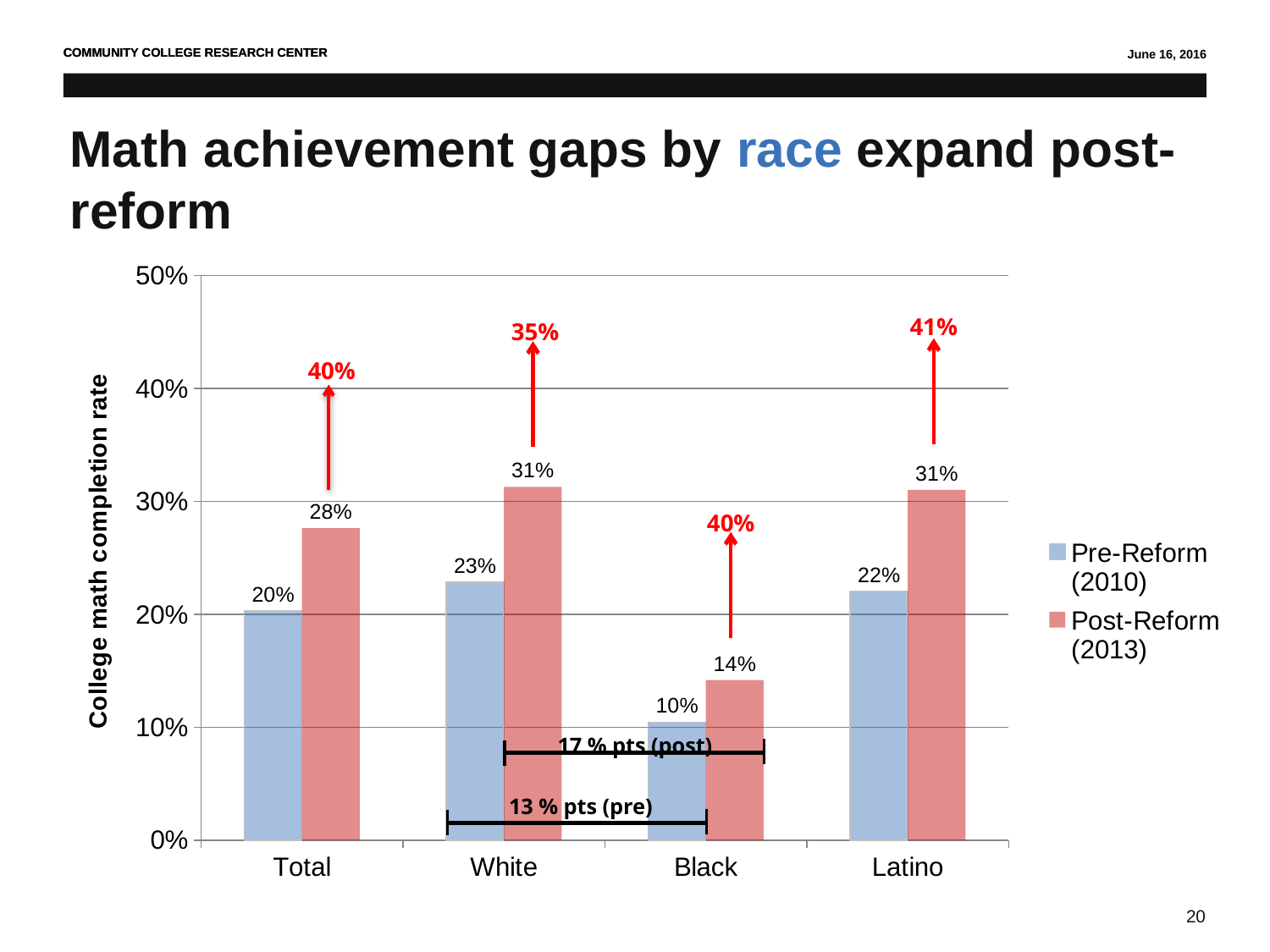
What is the Post-Reform (2013) value for the Total category? 28% What kind of chart is shown on the slide? bar chart How many categories are shown on the x axis? 4 How many series does the legend list? 2 Which category has the lowest Post-Reform (2013) completion rate? Black What is the Pre-Reform (2010) value for Latino students? 22% Which category has the highest Pre-Reform (2010) completion rate? White What is the Post-Reform (2013) college math completion rate for Black students? 14% What is the Pre-Reform (2010) college math completion rate for White students? 23% What is the label of the y axis? College math completion rate Is the Post-Reform (2013) value for White students larger or smaller than the Post-Reform (2013) value for Black students? larger What is the difference between the Post-Reform (2013) and Pre-Reform (2010) values for Latino students? 9%